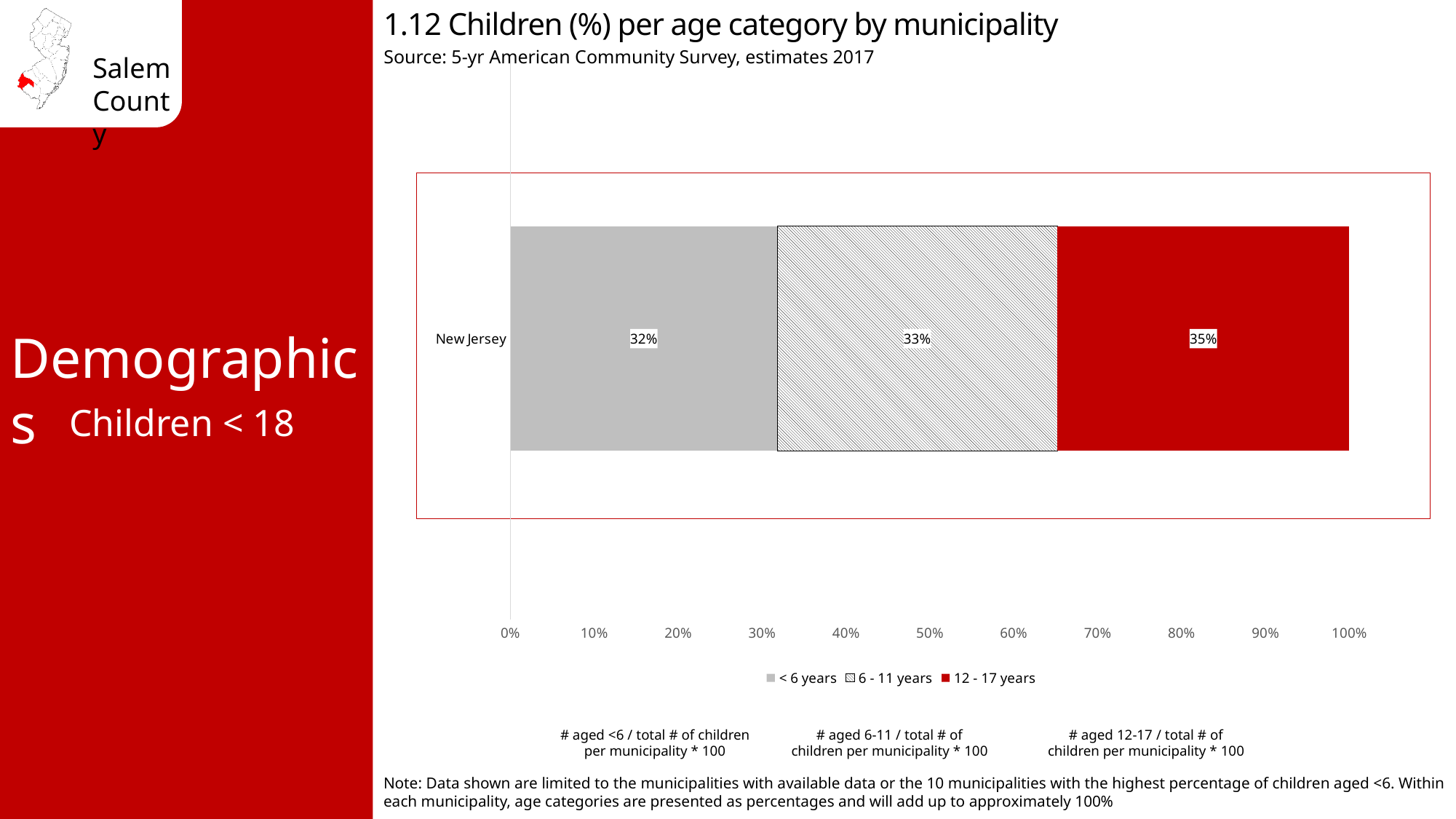
Which is larger for New Jersey: the 6 - 11 years share or the 12 - 17 years share? 12 - 17 years What percentage of children in New Jersey are aged under 6 years? 32% What kind of chart is shown on the slide? Stacked bar chart How many municipalities (categories) are plotted on the chart? 1 What percentage of children in New Jersey are aged 12 - 17 years? 35% Which age category has the lowest percentage of children in New Jersey? < 6 years What is the difference between the 12 - 17 years share and the < 6 years share for New Jersey? 3% Which age category has the highest percentage of children in New Jersey? 12 - 17 years How many series does the legend list? 3 What is the total of the three age category percentages shown for New Jersey? 100% What percentage of children in New Jersey are aged 6 - 11 years? 33% What is the title of the chart? 1.12 Children (%) per age category by municipality